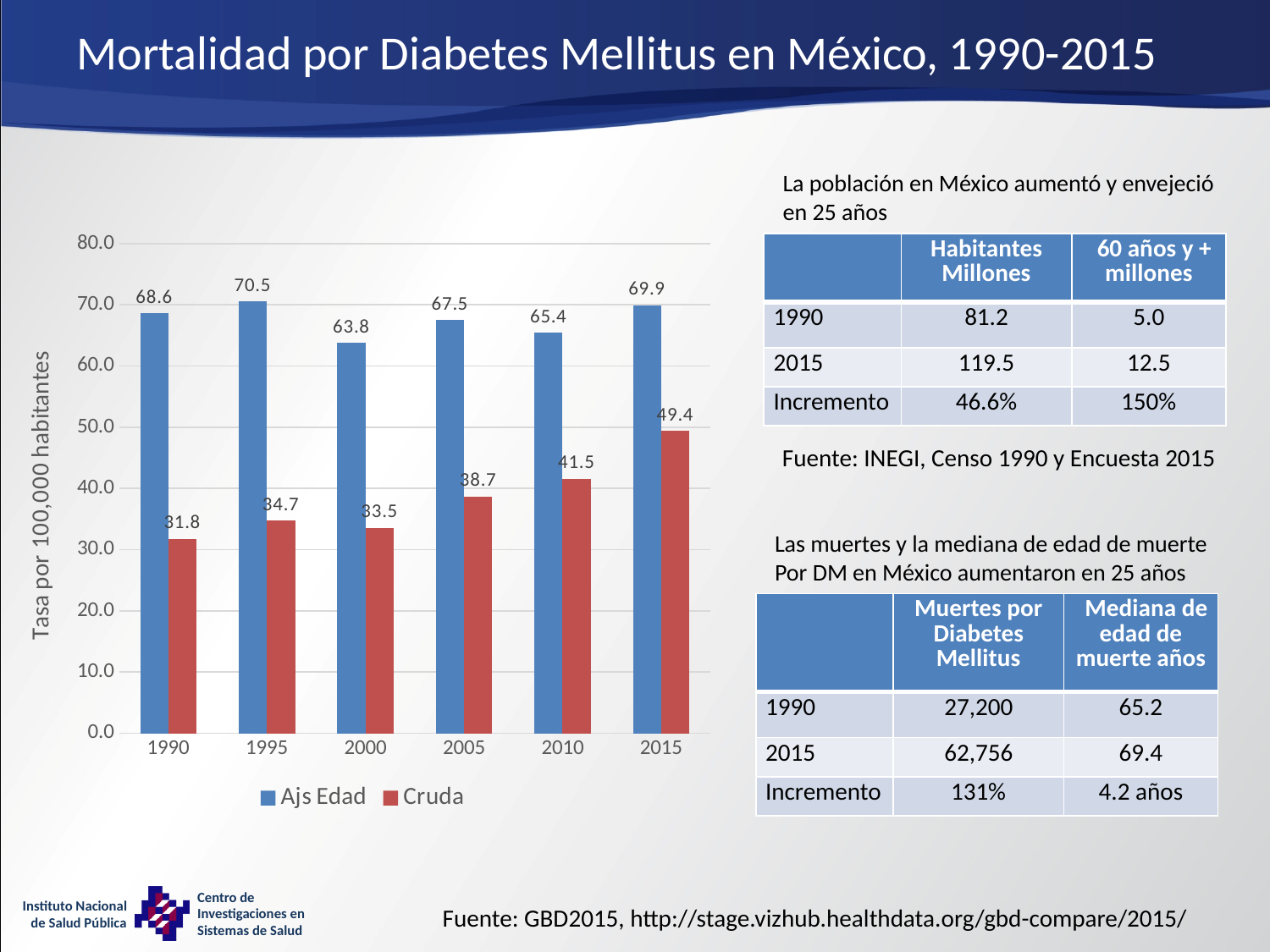
What kind of chart is shown on the slide? bar chart How many series does the chart legend list? 2 What is the Cruda value for 1990? 31.8 Which year has the lowest Ajs Edad value? 2000 Does the Cruda series rise or fall from 2000 to 2015? rise Which is larger, the Cruda value for 2005 or the Cruda value for 2000? 2005 What is the Ajs Edad value for 1995? 70.5 What is the difference between the Ajs Edad and Cruda values in 2015? 20.5 What is the Cruda value for 2015? 49.4 Which year has the lowest Cruda value? 1990 How many years are shown on the x axis of the chart? 6 Which year has the highest Ajs Edad value? 1995